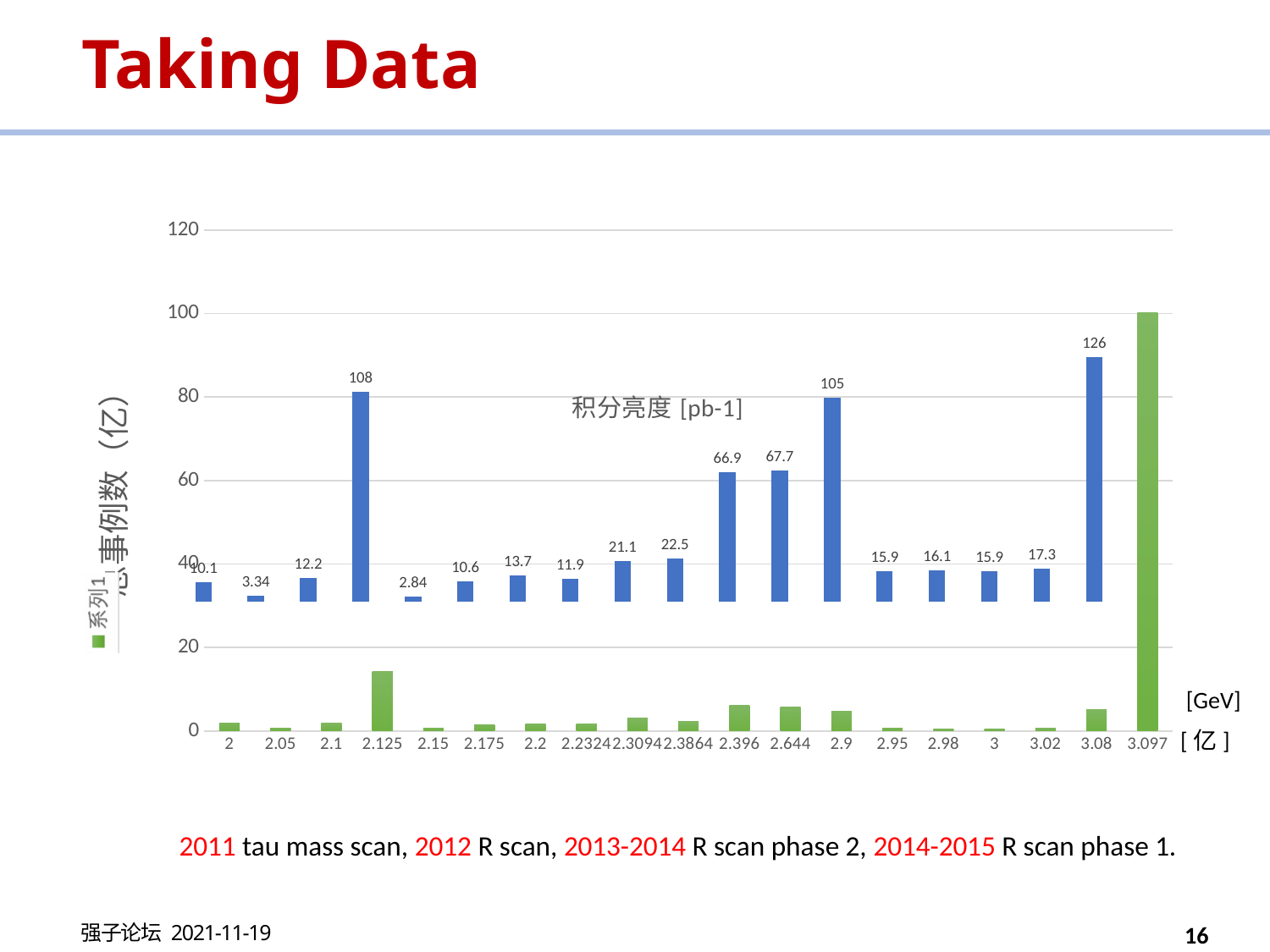
In the blue bar chart titled 积分亮度 [pb-1], which energy has the lowest value? 2.15 In the blue bar chart titled 积分亮度 [pb-1], what is the difference between the values at 3.08 GeV and 3.02 GeV? 108.7 In the blue bar chart titled 积分亮度 [pb-1], what is the difference between the values at 2.125 GeV and 2.9 GeV? 3 How many energy categories are shown on the x axis of the chart? 19 In the blue bar chart titled 积分亮度 [pb-1], what is the value at 2.9 GeV? 105 In the green bar chart, is the value at 2.125 GeV greater or less than 20? less In the blue bar chart titled 积分亮度 [pb-1], which is larger, the value at 2.396 GeV or at 2.644 GeV? 2.644 In the blue bar chart titled 积分亮度 [pb-1], which energy has the highest value? 3.08 What kind of chart is shown on the slide? bar chart In the blue bar chart titled 积分亮度 [pb-1], what is the value at 2.05 GeV? 3.34 In the blue bar chart titled 积分亮度 [pb-1], what is the value at 2.125 GeV? 108